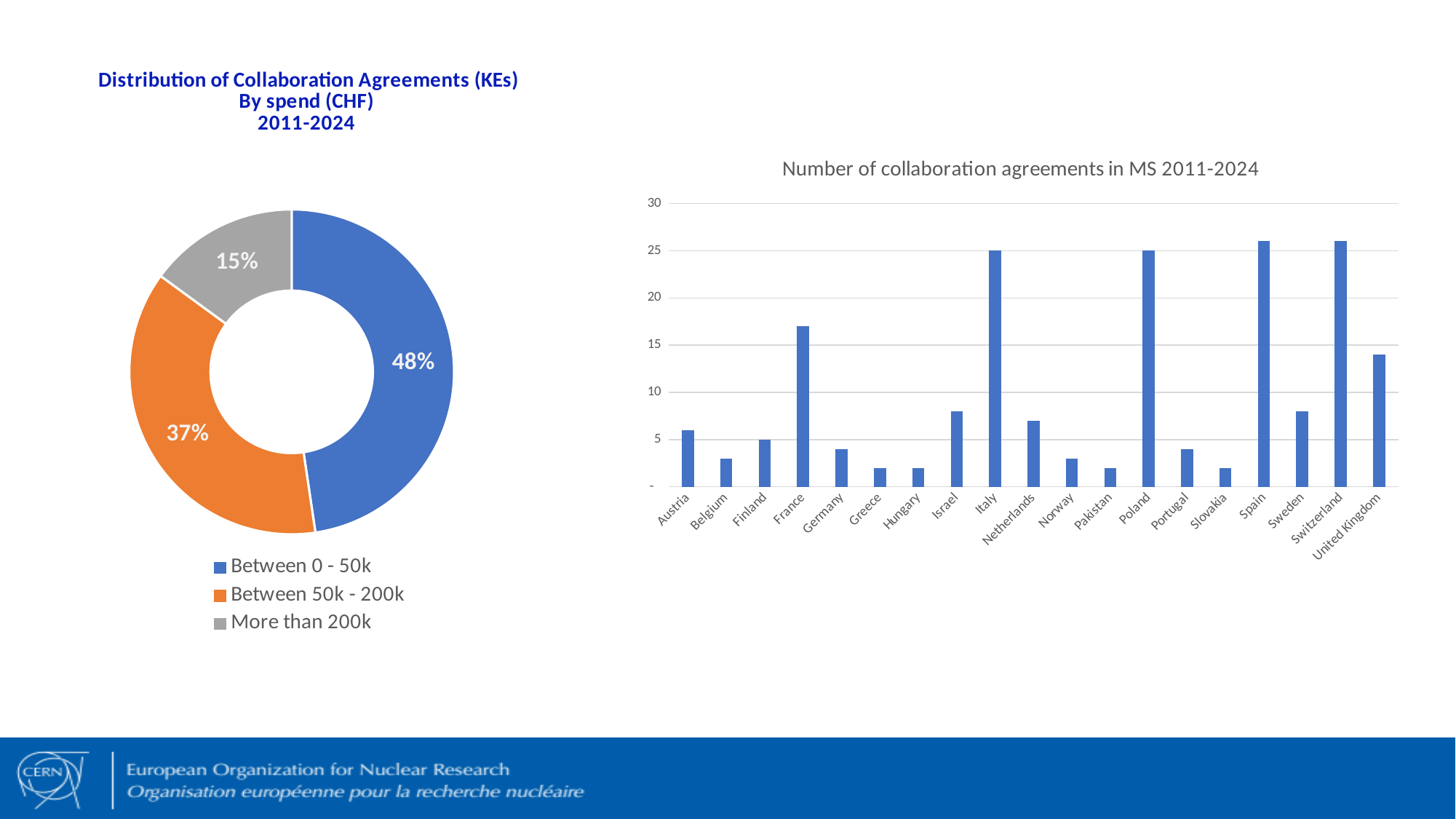
In the 'Number of collaboration agreements in MS 2011-2024' chart, is the value for France greater or less than 15? greater In the 'Distribution of Collaboration Agreements (KEs)' chart, which category has the largest share? Between 0 - 50k In the 'Distribution of Collaboration Agreements (KEs)' chart, how many percentage points larger is 'Between 0 - 50k' than 'Between 50k - 200k'? 11 In the 'Number of collaboration agreements in MS 2011-2024' chart, is the value for Israel greater or less than 10? less In the 'Distribution of Collaboration Agreements (KEs)' chart, what share is labelled for 'More than 200k'? 15% What kind of chart is the 'Number of collaboration agreements in MS 2011-2024' chart? Bar chart In the 'Distribution of Collaboration Agreements (KEs)' chart, what share is labelled for 'Between 0 - 50k'? 48% What kind of chart is the 'Distribution of Collaboration Agreements (KEs)' chart? Doughnut (pie) chart In the 'Number of collaboration agreements in MS 2011-2024' chart, which has the larger value, Italy or Netherlands? Italy In the 'Distribution of Collaboration Agreements (KEs)' chart, how many categories does the legend list? 3 In the 'Number of collaboration agreements in MS 2011-2024' chart, how many countries are shown on the x axis? 19 In the 'Distribution of Collaboration Agreements (KEs)' chart, which category has the smallest share? More than 200k